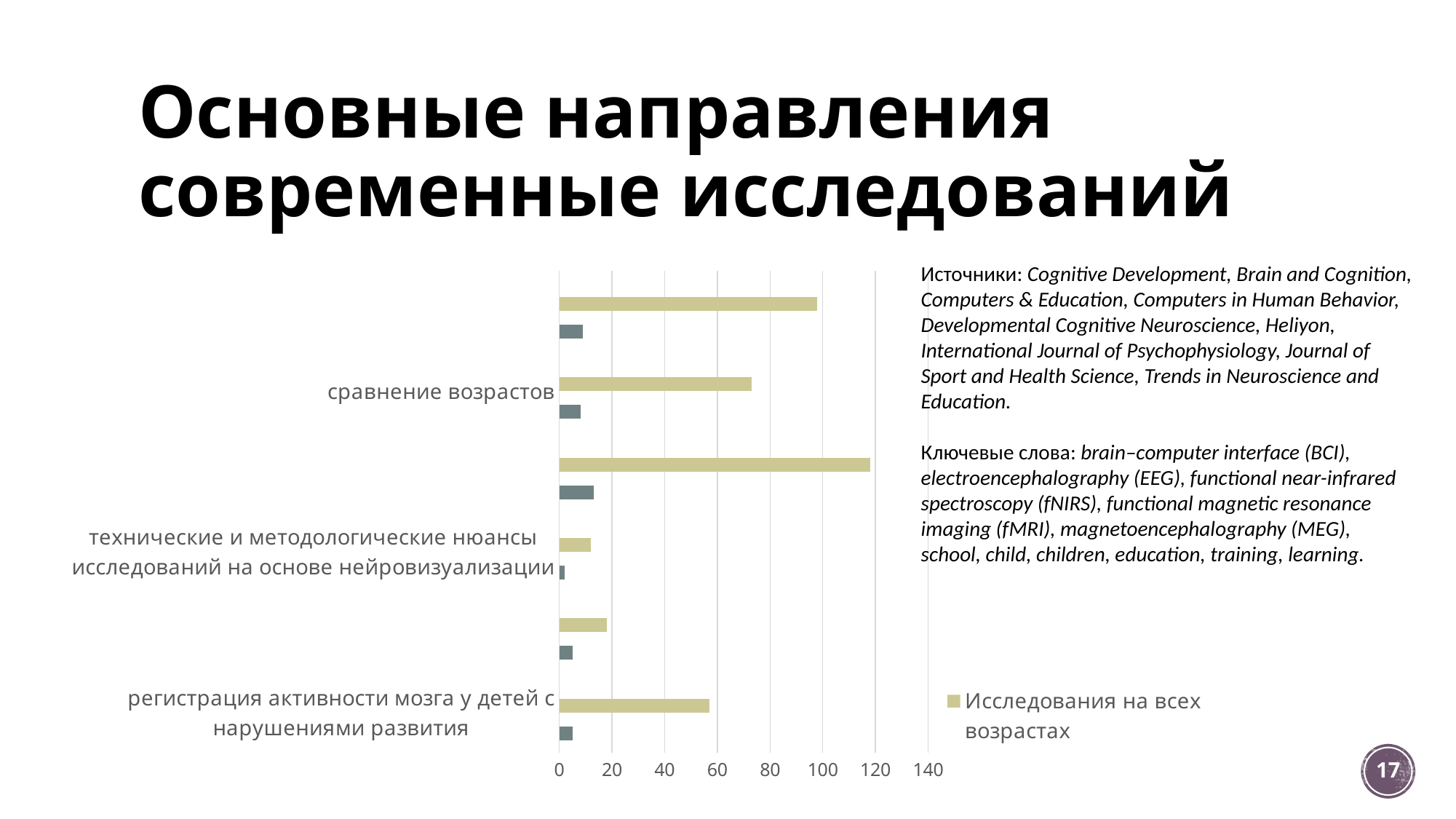
What kind of chart is shown on the slide? bar chart Is the value of 'Исследования на всех возрастах' for 'регистрация активности мозга у детей с нарушениями развития' greater or less than 80? less Is the value of 'Исследования на всех возрастах' for 'регистрация активности мозга у детей с нарушениями развития' greater or less than 40? greater Which series is named in the chart legend? Исследования на всех возрастах Is the value of 'Исследования на всех возрастах' for 'технические и методологические нюансы исследований на основе нейровизуализации' greater or less than 20? less For 'Исследования на всех возрастах', which is larger: 'сравнение возрастов' or 'регистрация активности мозга у детей с нарушениями развития'? сравнение возрастов For 'сравнение возрастов', which bar is longer: the 'Исследования на всех возрастах' bar or the dark grey bar? Исследования на всех возрастах What is the highest value shown on the chart's horizontal axis? 140 For 'Исследования на всех возрастах', which is larger: 'технические и методологические нюансы исследований на основе нейровизуализации' or 'регистрация активности мозга у детей с нарушениями развития'? регистрация активности мозга у детей с нарушениями развития